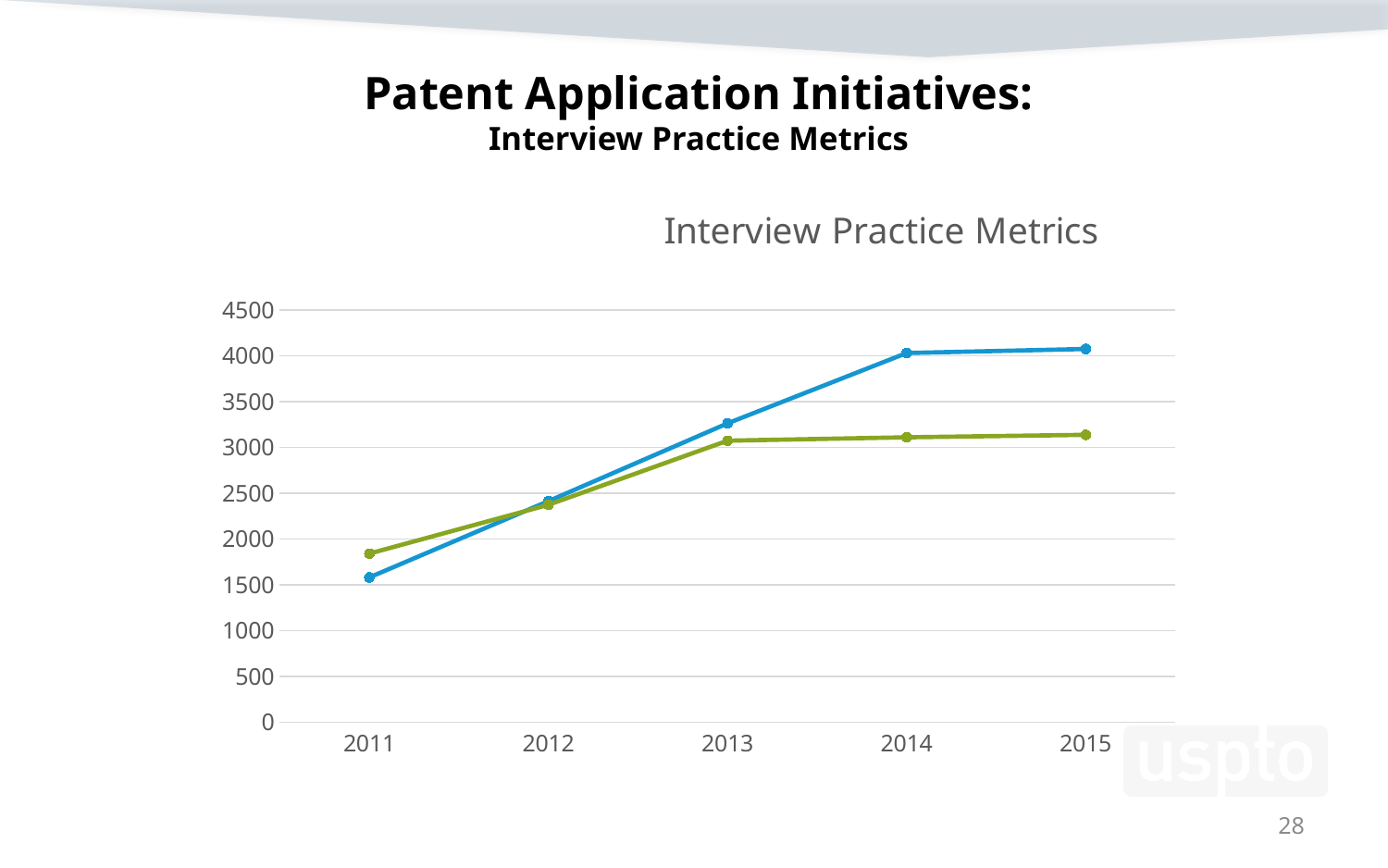
How many lines are plotted on the chart? 2 What kind of chart is shown on the slide? Line chart Is the value of the blue line for 2013 greater or less than 3000? greater Is the value of the green line for 2015 greater or less than 3500? less In 2015, which line has the higher value, the blue line or the green line? The blue line What is the title of the chart? Interview Practice Metrics Is the value of the green line for 2011 greater or less than 1500? greater How many years are plotted along the x axis of the chart? 5 In 2011, which line has the higher value, the blue line or the green line? The green line Does the blue line generally rise or fall from 2011 to 2015? Rise